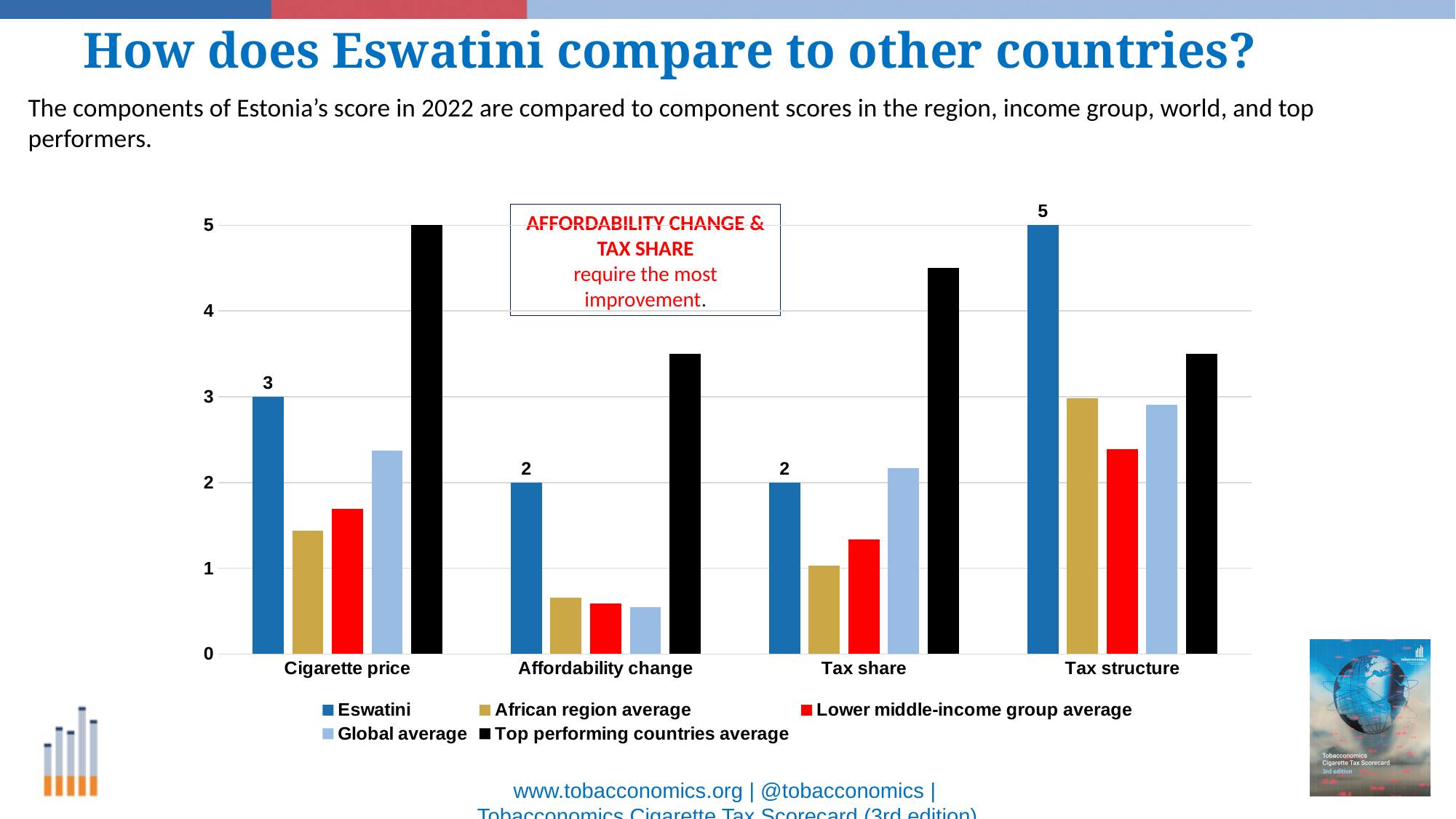
Is the value for Top performing countries average in the Affordability change category greater or less than 3? greater What is the difference between Eswatini's Tax structure value and its Cigarette price value? 2 What is the value for Eswatini in the Cigarette price category? 3 What is the value for Eswatini in the Tax structure category? 5 In which category is the African region average lowest? Affordability change In the Cigarette price category, which is larger: Eswatini or Top performing countries average? Top performing countries average What is the value for Eswatini in the Affordability change category? 2 In the Tax structure category, which is larger: Eswatini or Global average? Eswatini How many series does the chart's legend list? 5 What kind of chart is shown on the slide? bar chart How many categories are shown on the x axis of the chart? 4 In which category does Eswatini have its highest value? Tax structure